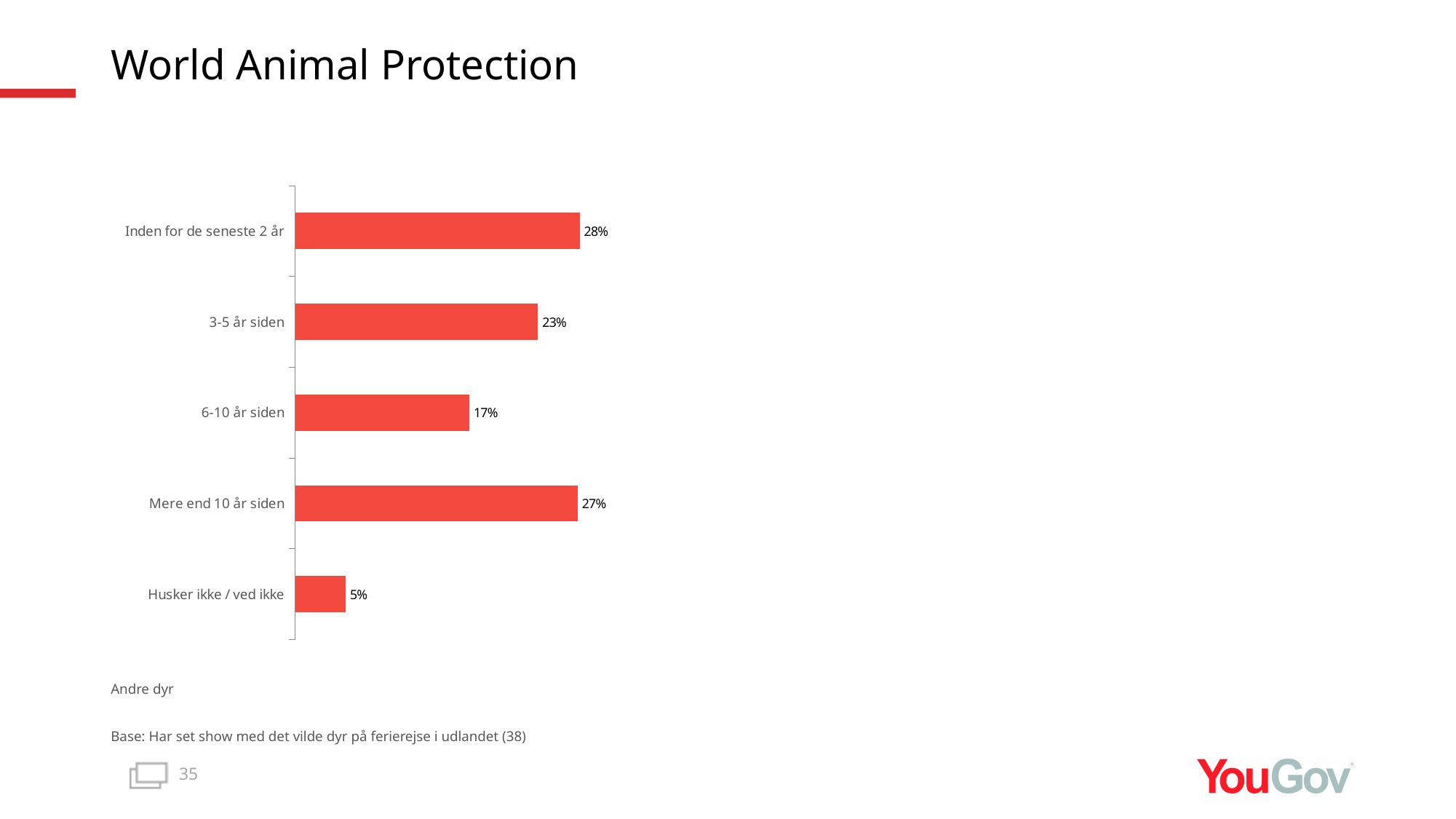
How many categories are shown in the chart? 5 What is the value for "Inden for de seneste 2 år"? 28% Which is larger: "3-5 år siden" or "Mere end 10 år siden"? Mere end 10 år siden What is the difference between "Mere end 10 år siden" and "Husker ikke / ved ikke"? 22% What is the value for "Husker ikke / ved ikke"? 5% What is the difference between "Inden for de seneste 2 år" and "6-10 år siden"? 11% What is the base size stated below the chart? 38 Which category has the highest value? Inden for de seneste 2 år What is the value for "3-5 år siden"? 23% Which category has the lowest value? Husker ikke / ved ikke What kind of chart is shown on the slide? Bar chart What is the value for "6-10 år siden"? 17%